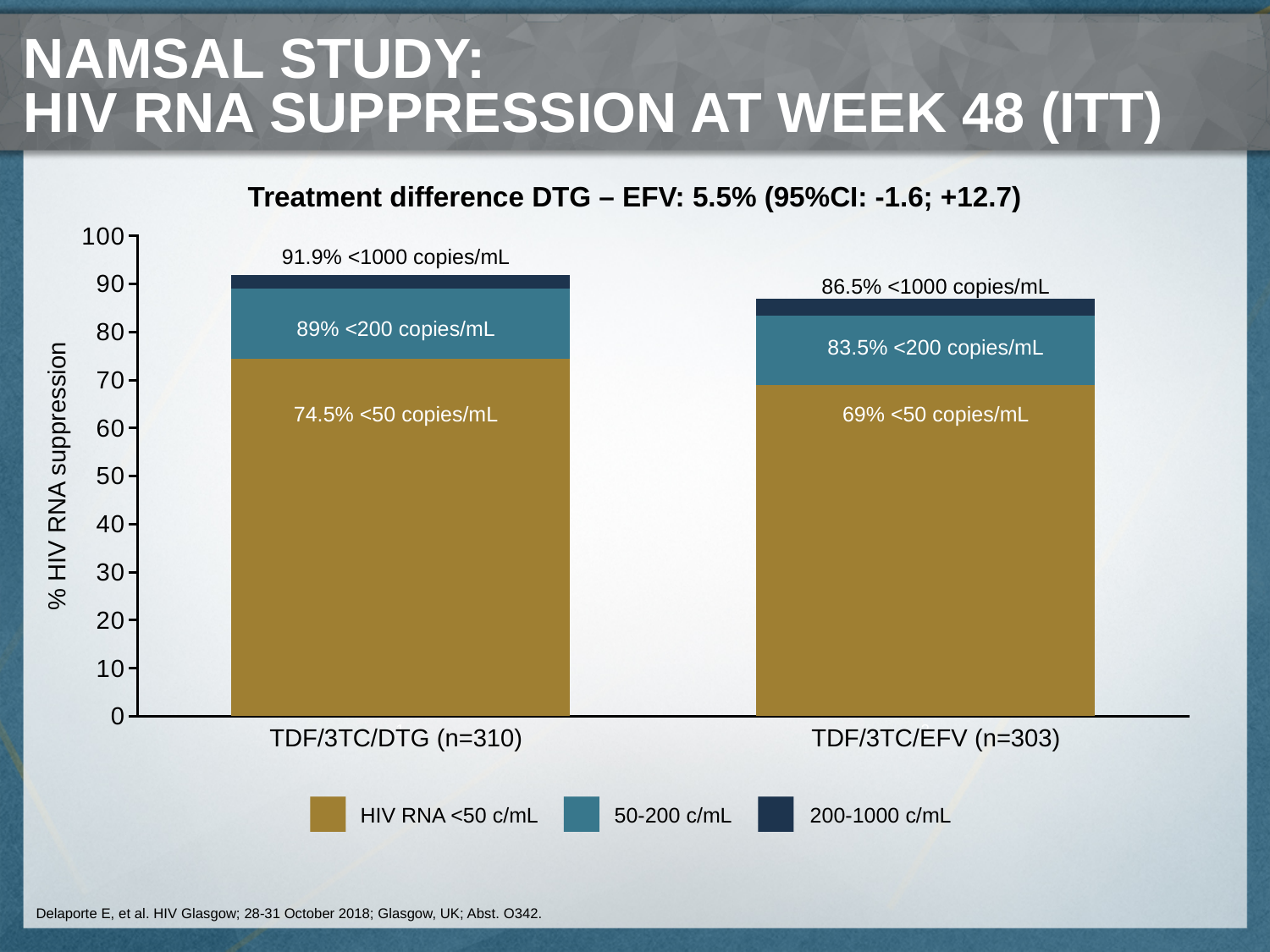
How many series does the legend list? 3 What is the total height of the stacked bar for TDF/3TC/DTG, i.e. the percentage with HIV RNA <1000 copies/mL? 91.9% What percentage of patients in the TDF/3TC/DTG arm had HIV RNA <200 copies/mL? 89% What percentage of patients in the TDF/3TC/EFV arm had HIV RNA <1000 copies/mL? 86.5% Is the percentage with HIV RNA <50 copies/mL in the TDF/3TC/EFV arm greater or less than 70? less Which treatment arm has the higher percentage of patients with HIV RNA <50 copies/mL? TDF/3TC/DTG What type of chart is shown on the slide? Stacked bar chart How many treatment arms (bars) are shown in the chart? 2 What is the difference between the two arms in the percentage of patients with HIV RNA <200 copies/mL? 5.5% What percentage of patients in the TDF/3TC/DTG arm had HIV RNA <50 copies/mL? 74.5% What percentage of patients in the TDF/3TC/EFV arm had HIV RNA <50 copies/mL? 69% What is the difference between the two arms in the percentage of patients with HIV RNA <50 copies/mL? 5.5%